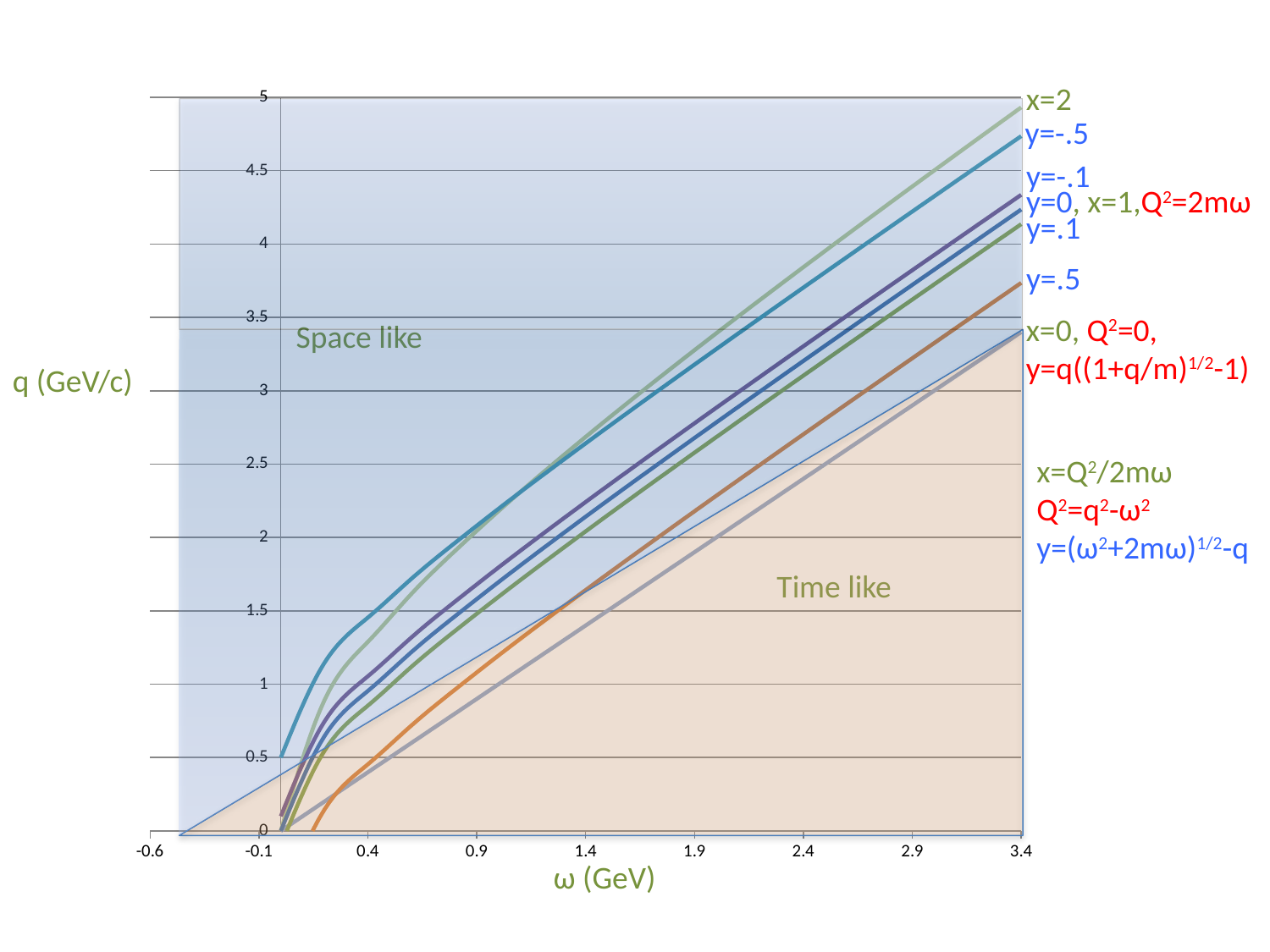
What are the two region labels written inside the plot area? Space like and Time like What kind of chart is shown on the slide? line chart At ω = 1.9, which curve has the higher q value, y=-.5 or y=.5? y=-.5 At ω = 3.4, is the q value of the x=2 curve greater or less than 4.5? greater Which labeled curve has the lowest q value at ω = 3.4? x=0, Q²=0 At ω = 3.4, is the q value of the y=.5 curve greater or less than 4? less What is the highest tick value shown on the q axis? 5 What is the label of the horizontal axis? ω (GeV) Which labeled curve reaches the highest q value at ω = 3.4? x=2 How many labeled curves are plotted on the chart? 7 Do the curves rise or fall as ω increases? rise At ω = 1.9, is the q value of the y=-.5 curve greater or less than 3? greater